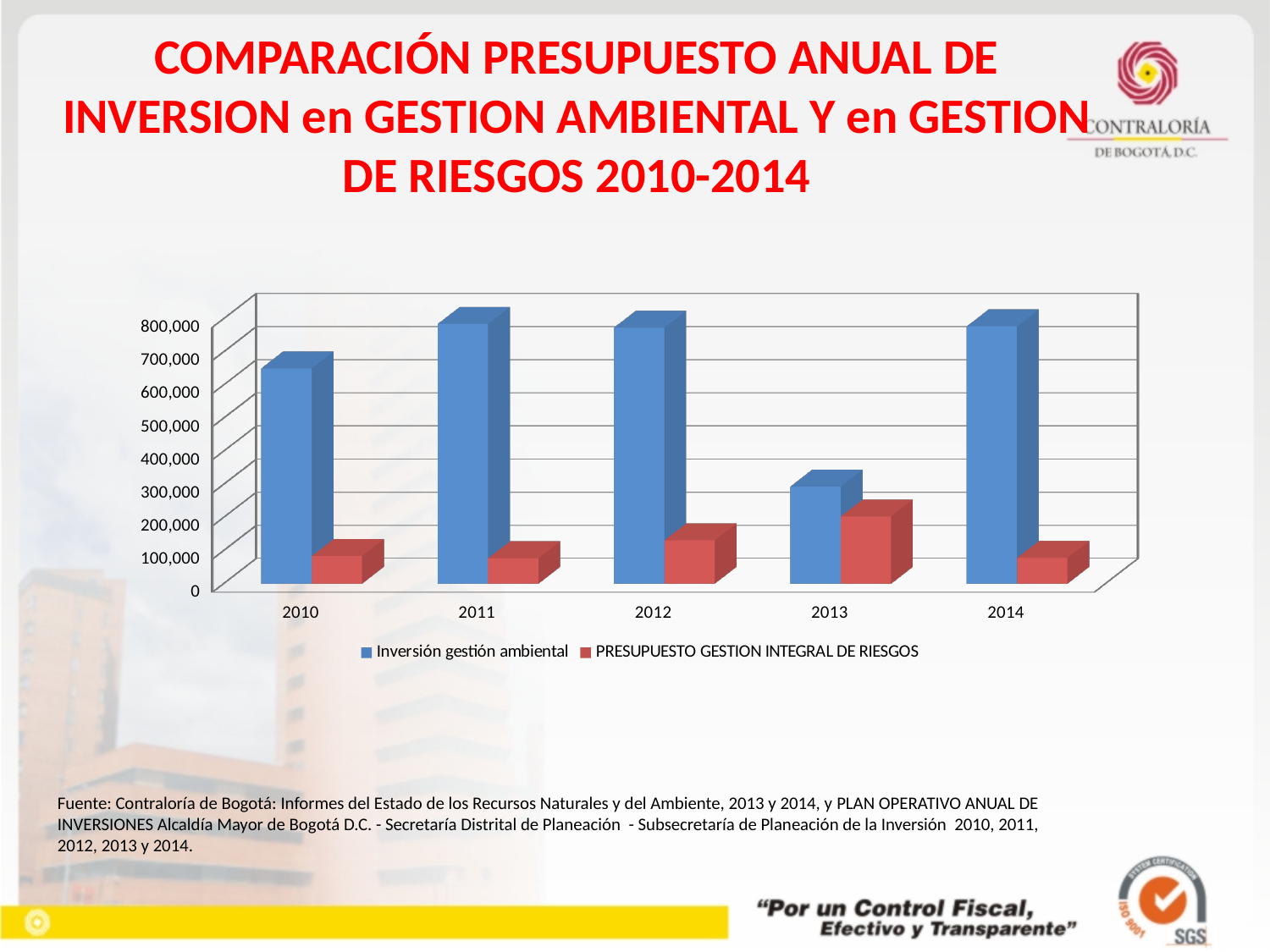
Is the value for Inversión gestión ambiental in 2013 greater or less than 400,000? less What kind of chart is shown on the slide? Bar chart Is the value for PRESUPUESTO GESTION INTEGRAL DE RIESGOS in 2013 greater or less than 100,000? greater How many years (categories) are shown on the x axis of the chart? 5 Is the value for Inversión gestión ambiental in 2010 greater or less than 500,000? greater In which year is the value for PRESUPUESTO GESTION INTEGRAL DE RIESGOS highest? 2013 In which year is the value for Inversión gestión ambiental lowest? 2013 Which is larger: Inversión gestión ambiental in 2010 or Inversión gestión ambiental in 2013? 2010 Which is larger: PRESUPUESTO GESTION INTEGRAL DE RIESGOS in 2012 or in 2013? 2013 How many series does the chart legend list? 2 Which colour represents the series Inversión gestión ambiental in the chart? Blue